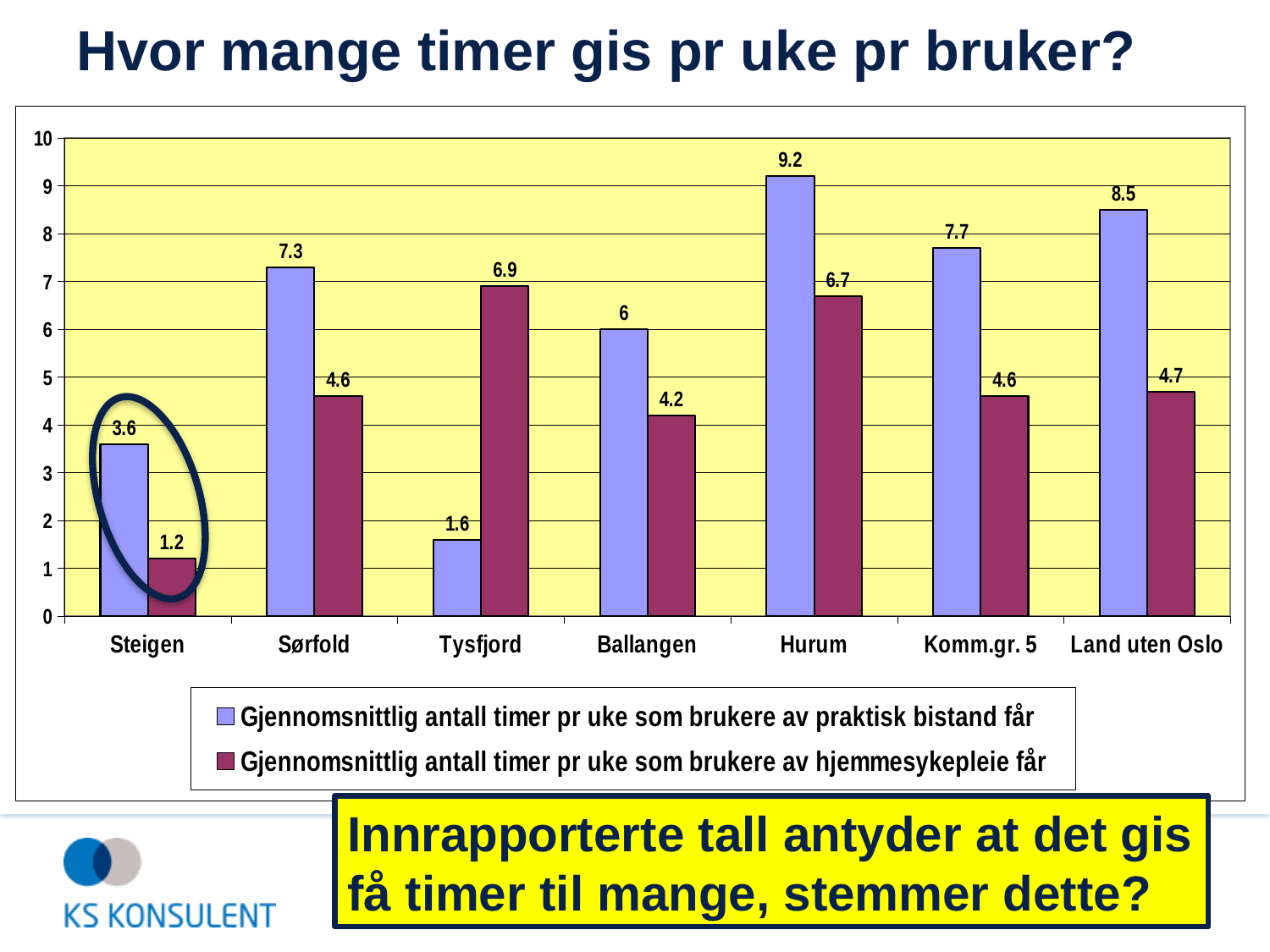
What is the average number of hours per week for users of praktisk bistand in Hurum? 9.2 Which is larger in Tysfjord: the praktisk bistand value or the hjemmesykepleie value? hjemmesykepleie (6.9) How many categories are shown on the x axis? 7 What is the average number of hours per week for users of hjemmesykepleie in Steigen? 1.2 How many series does the legend list? 2 What is the value for hjemmesykepleie in Tysfjord? 6.9 Which category has the highest value for praktisk bistand? Hurum Which category has the lowest value for hjemmesykepleie? Steigen Is the praktisk bistand value for Land uten Oslo greater or less than 8? greater What kind of chart is shown on the slide? Bar chart What is the difference between the praktisk bistand and hjemmesykepleie values for Sørfold? 2.7 Which category is circled on the chart? Steigen